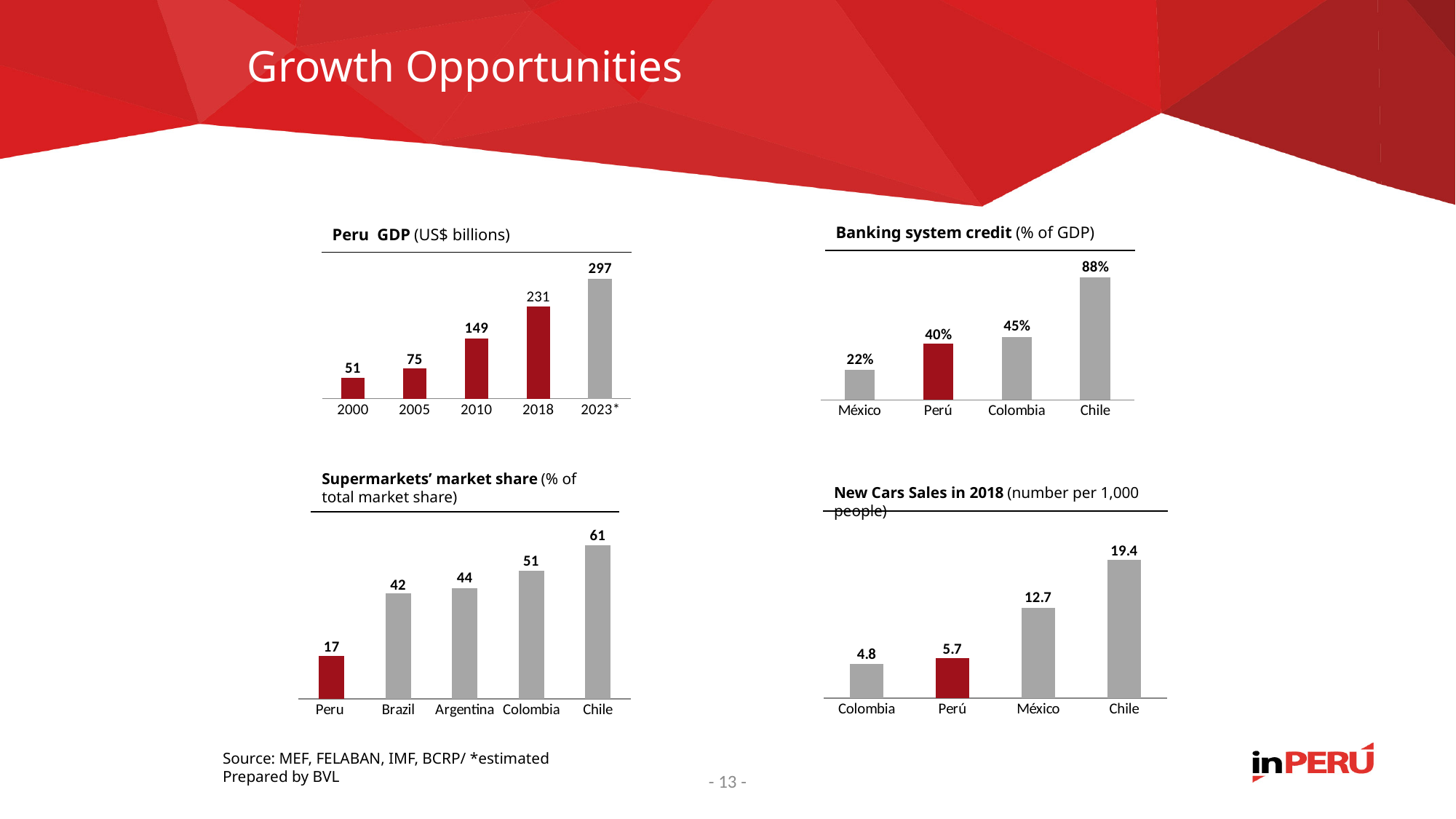
What kind of chart is the New Cars Sales in 2018 chart? bar chart In the Banking system credit chart, which country has the lowest value? México In the Peru GDP chart, what is the estimated value for 2023*? 297 In the Banking system credit chart, what is the value for Perú? 40% In the Banking system credit chart, which country has the highest value? Chile In the Peru GDP chart, do the values rise or fall from 2000 to 2023*? rise In the Supermarkets' market share chart, what is the value for Argentina? 44 In the Peru GDP chart, what is the value for 2018? 231 In the Supermarkets' market share chart, how many countries are shown? 5 In the Supermarkets' market share chart, which is larger, Brazil or Colombia? Colombia In the New Cars Sales in 2018 chart, what is the value for México? 12.7 In the Peru GDP chart, what is the difference between the 2010 and 2005 values? 74